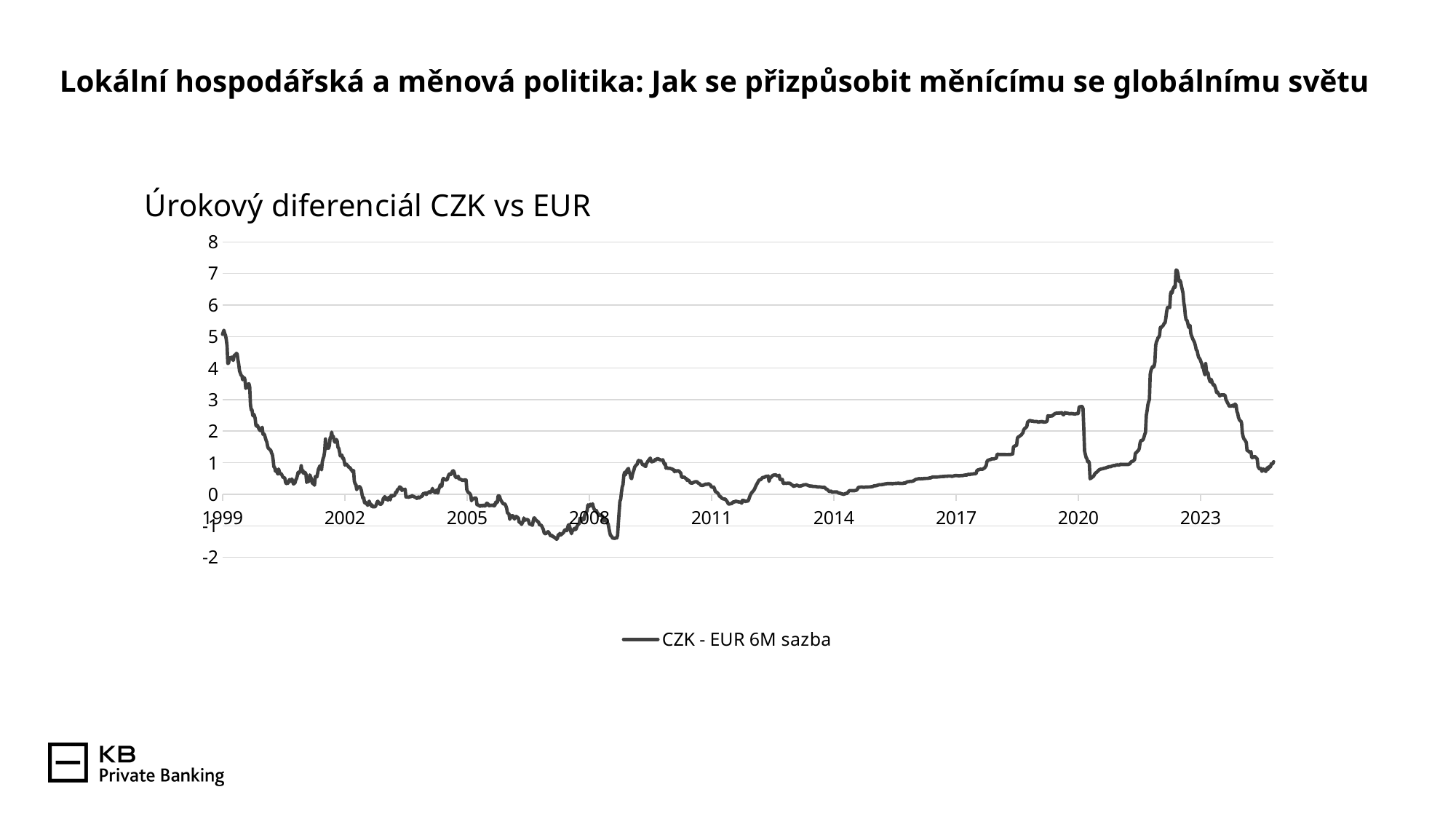
Is the value for 2014 greater or less than 1? less What kind of chart is shown on the slide? line chart Is the value for 2008 greater or less than 0? less Is the highest point of the line greater or less than 6? greater What is the title of the chart? Úrokový diferenciál CZK vs EUR Does the line rise or fall between 1999 and 2002? fall Does the line rise or fall between 2014 and 2020? rise What is the legend entry for the plotted series? CZK - EUR 6M sazba How many series does the legend list? 1